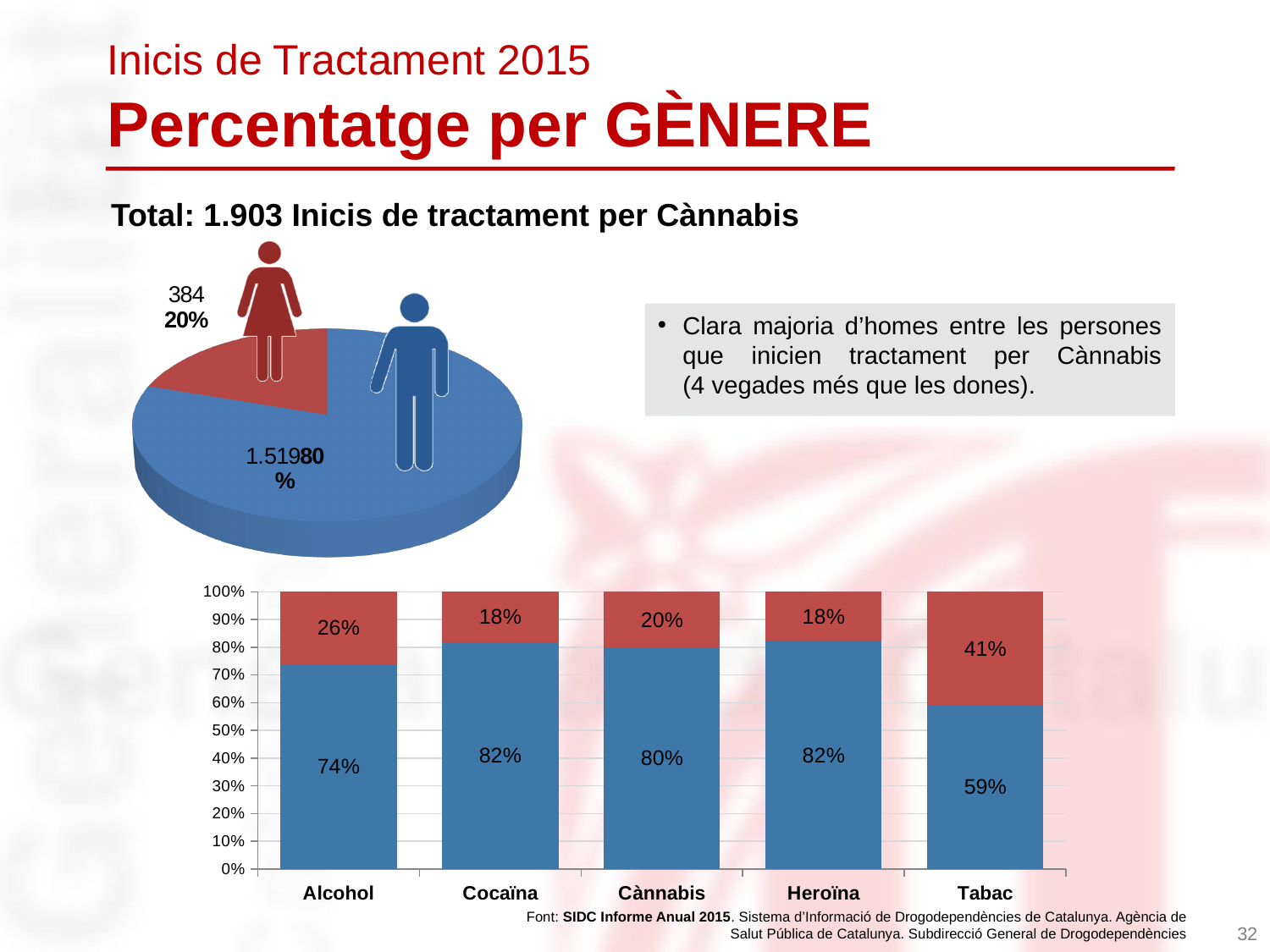
In the stacked bar chart at the bottom, which category has the largest red (upper) segment? Tabac How many categories are shown on the x axis of the stacked bar chart at the bottom? 5 In the stacked bar chart at the bottom, which category has the smallest blue (lower) segment? Tabac In the stacked bar chart at the bottom, what is the value of the red (upper) segment for Alcohol? 26% In the pie chart, what count is labelled on the red slice? 384 In the stacked bar chart at the bottom, which has a larger blue (lower) segment, Alcohol or Cànnabis? Cànnabis What kind of chart is shown at the bottom of the slide? Stacked bar chart In the stacked bar chart at the bottom, what is the difference between the blue and red segments for Tabac? 18% In the stacked bar chart at the bottom, what is the total of the Alcohol bar? 100% In the stacked bar chart at the bottom, what is the value of the blue (lower) segment for Tabac? 59% In the pie chart, what share does the blue slice represent? 80% What kind of chart is shown at the top left of the slide? Pie chart